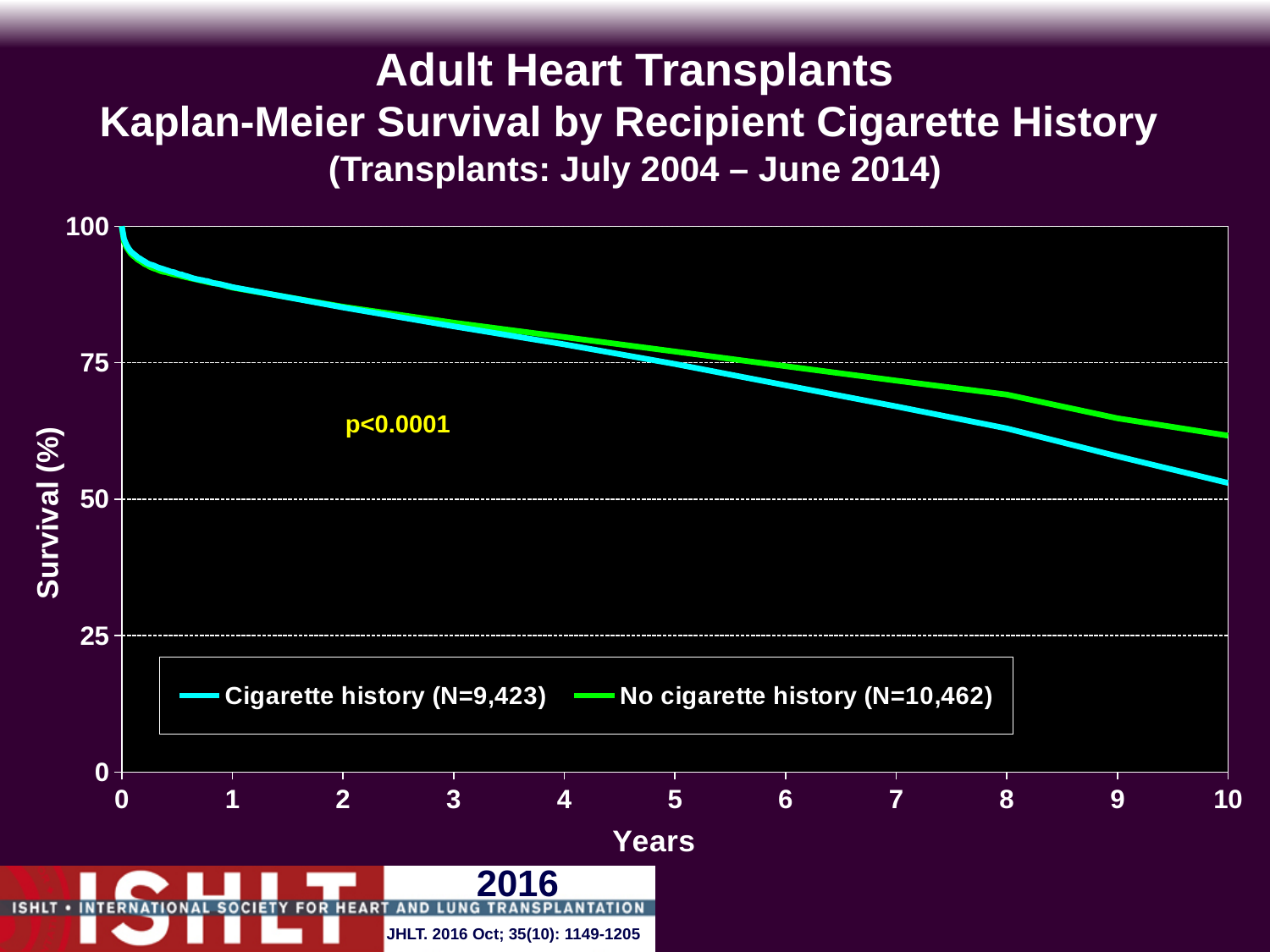
What kind of chart is shown on the slide? Line chart Which group has the lower survival at 8 years? Cigarette history What is the N for the No cigarette history group shown in the legend? 10,462 Is the survival for the Cigarette history group at 10 years greater or less than 75? less What is the N for the Cigarette history group shown in the legend? 9,423 Do the survival curves rise or fall as years increase? Fall Is the survival for the Cigarette history group at 2 years greater or less than 75? greater What p-value is printed on the chart? p<0.0001 At 10 years, which group has higher survival: Cigarette history or No cigarette history? No cigarette history Is the survival for the No cigarette history group at 10 years greater or less than 50? greater What is the label of the y axis? Survival (%) How many series does the legend list? 2